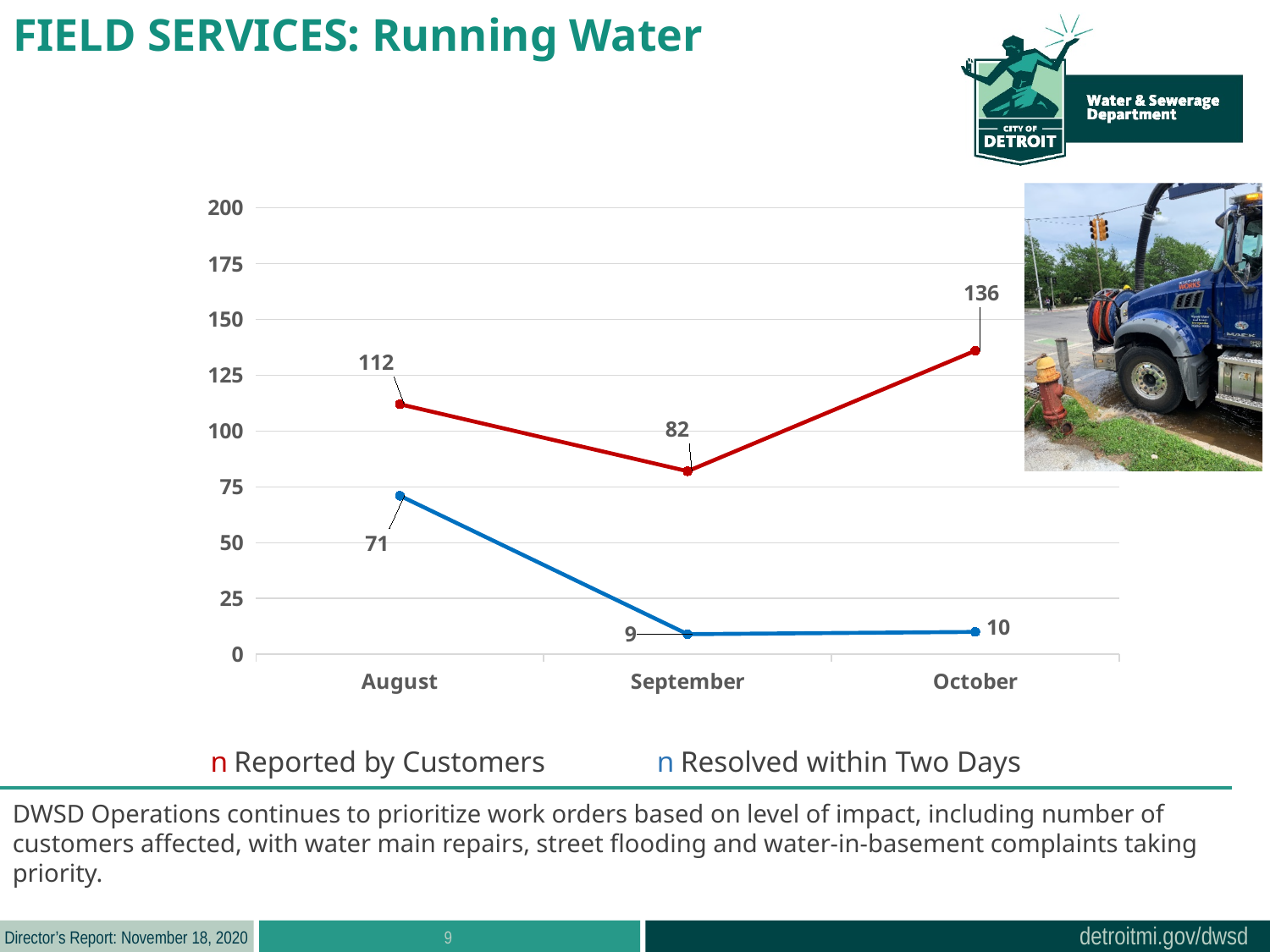
How many months are shown on the x axis? 3 What is the value for Resolved within Two Days in September? 9 How many series does the legend list? 2 What is the value for Reported by Customers in August? 112 Does the Resolved within Two Days series rise or fall from August to September? Fall What is the value for Reported by Customers in October? 136 In which month is the Resolved within Two Days value highest? August In which month is the Reported by Customers value lowest? September What kind of chart is shown on the slide? Line chart What is the difference between the Reported by Customers values for October and September? 54 Which is larger: Resolved within Two Days in August or Reported by Customers in September? Reported by Customers in September What is the difference between Reported by Customers and Resolved within Two Days in October? 126